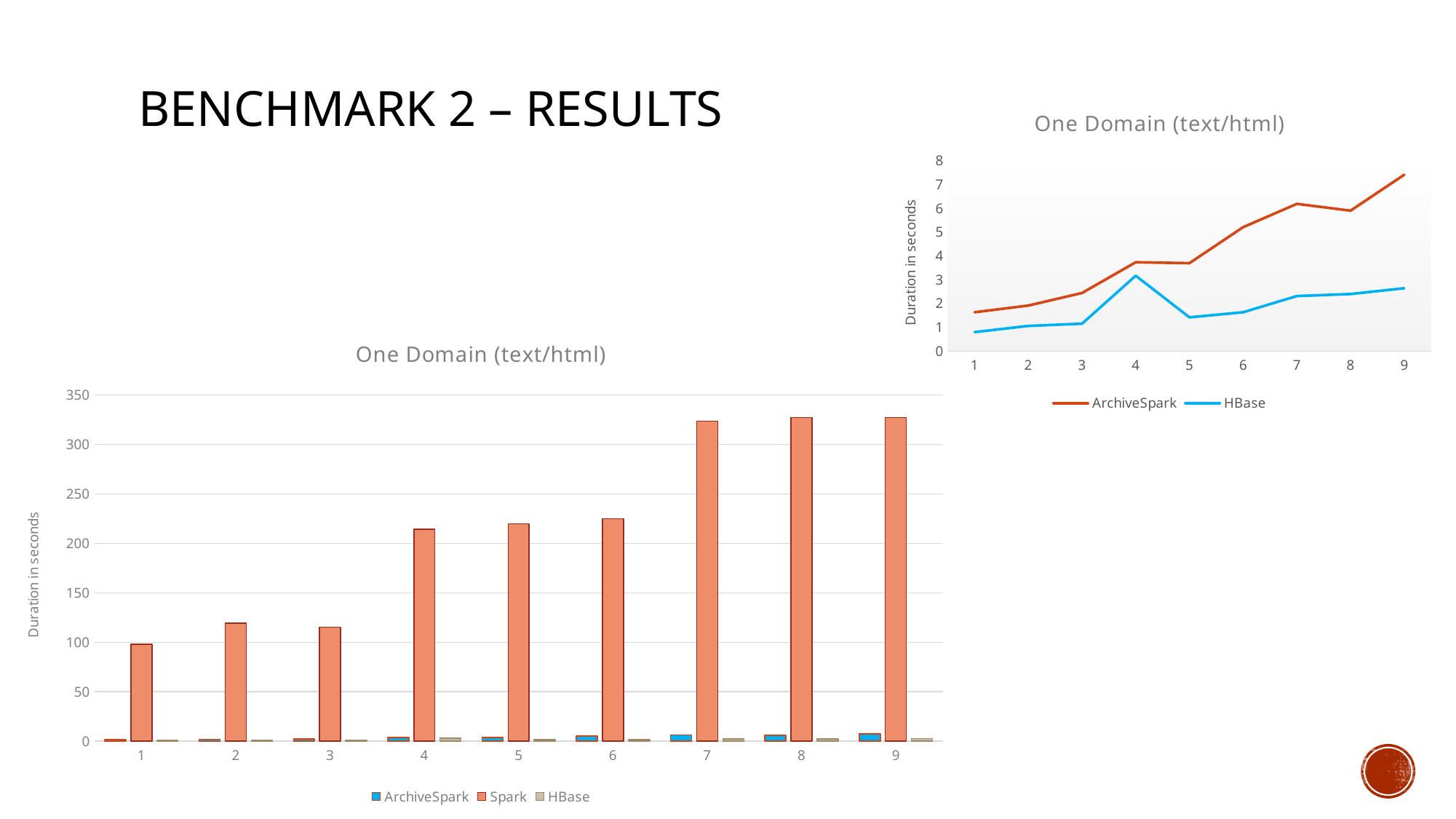
In the bar chart at the bottom left, is the Spark value for category 2 greater or less than 100? greater What kind of chart is the chart at the bottom left of the slide? bar chart In the bar chart at the bottom left, is the Spark value for category 7 greater or less than 300? greater In the line chart at the top right, how many series does the legend list? 2 What kind of chart is the chart at the top right of the slide? line chart In the line chart at the top right, at which point does the HBase series reach its highest value? 4 In the bar chart at the bottom left, how many categories are shown on the x axis? 9 In the bar chart at the bottom left, which is larger, the Spark value for category 3 or for category 4? category 4 In the line chart at the top right, which series has the higher value at point 4? ArchiveSpark In the line chart at the top right, is the ArchiveSpark value at point 9 greater or less than 7? greater In the bar chart at the bottom left, how many series does the legend list? 3 In the bar chart at the bottom left, which category has the lowest Spark value? 1